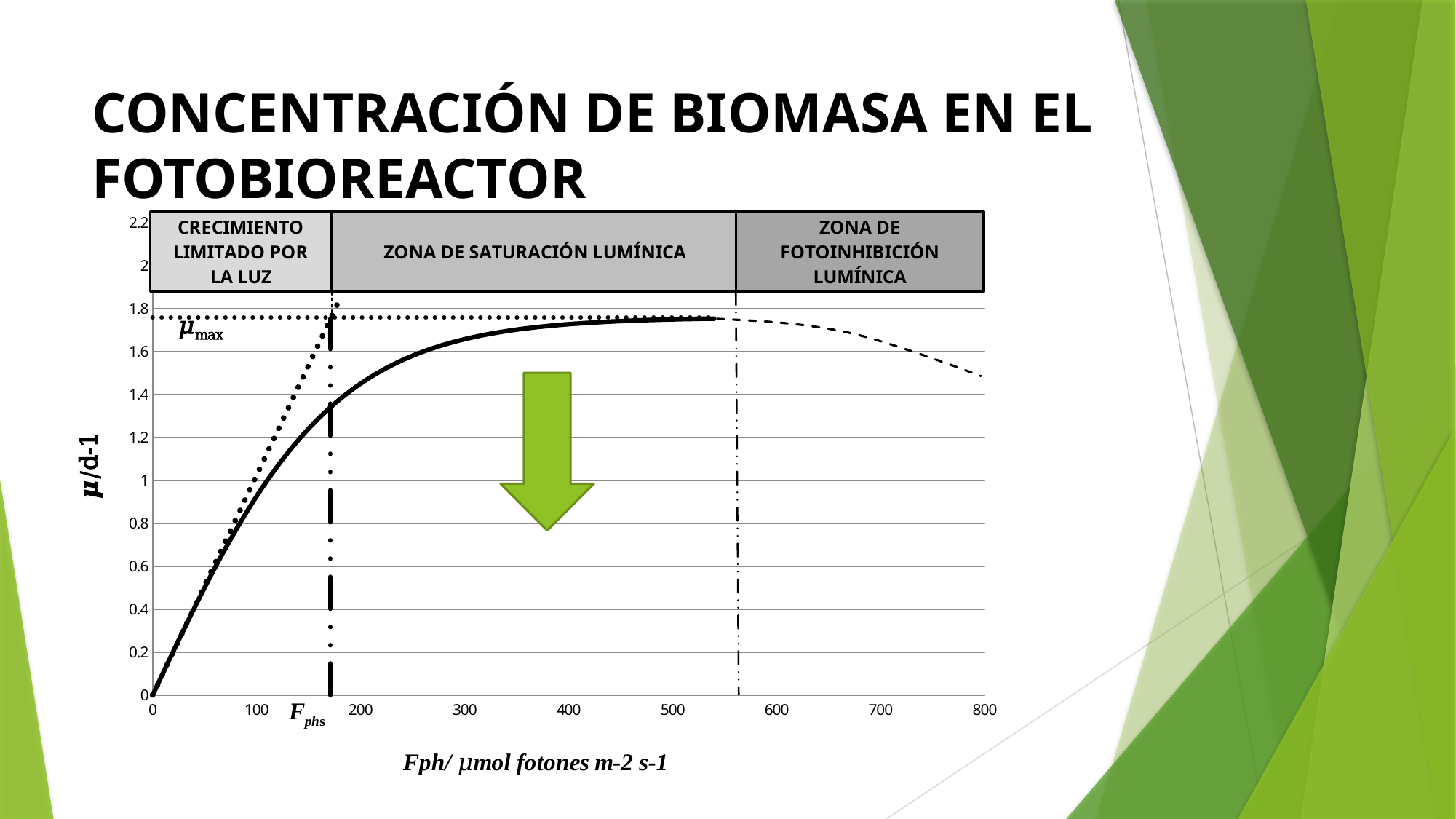
What is the highest tick value shown on the x axis? 800 Is the maximum value of μ reached by the curve greater or less than 2? less Is the value of μ at Fph = 800 greater or less than 1.6? less What kind of chart is shown on the slide? line chart Is the value of μ at Fph = 200 greater or less than 1.2? greater What is the x-axis title of the chart? Fph/ μmol fotones m-2 s-1 What is the value of μ at Fph = 0? 0 What is the label of the zone between the two vertical dashed lines? ZONA DE SATURACIÓN LUMÍNICA Does the curve rise or fall as Fph increases from 0 to 200? rise Does the dashed part of the curve rise or fall as Fph increases from 600 to 800? fall How many labelled zones are marked across the top of the chart? 3